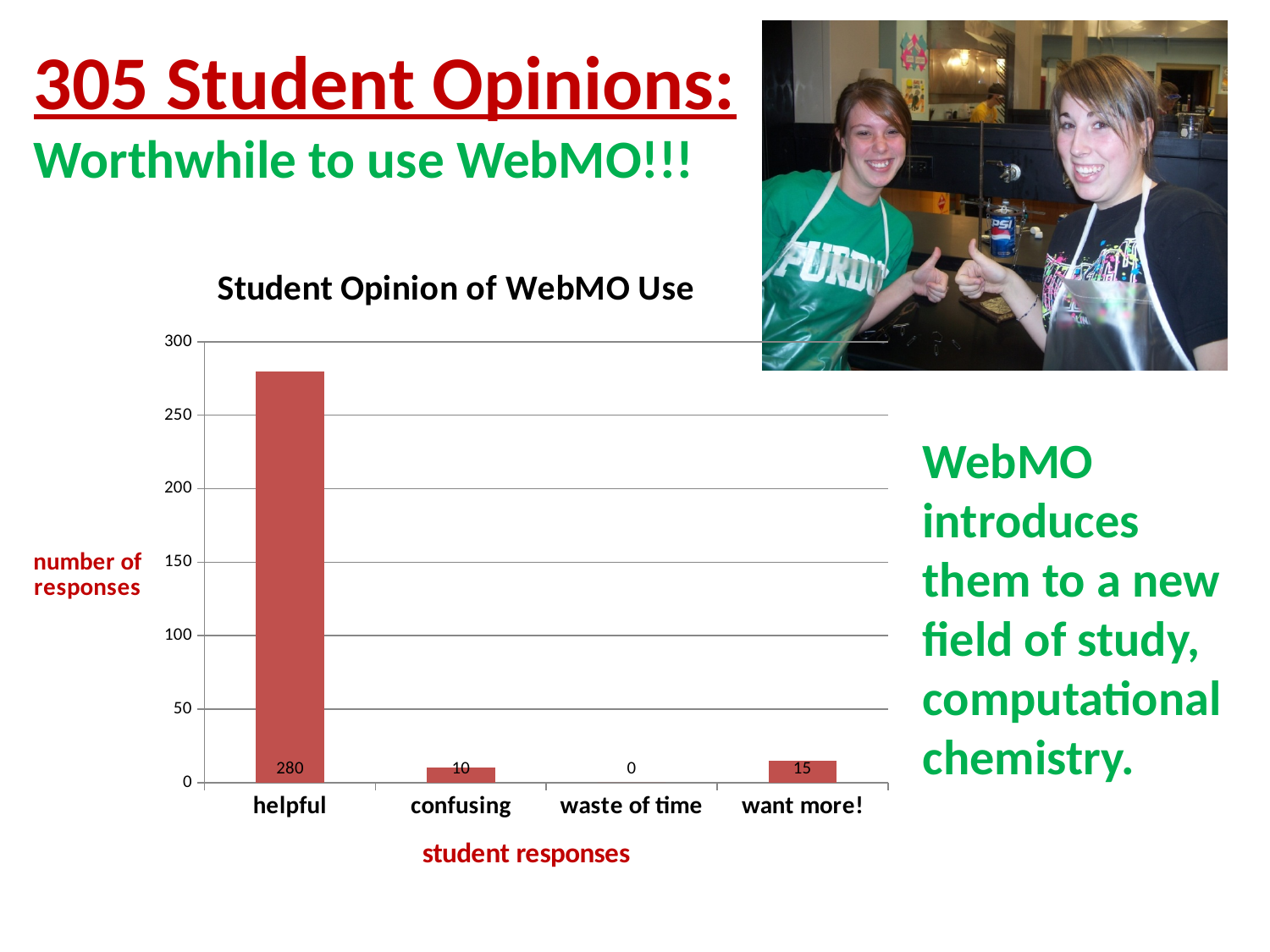
What is the number of responses for "confusing"? 10 What is the title of the chart? Student Opinion of WebMO Use What kind of chart is shown on the slide? bar chart Is the value for "helpful" greater or less than 250? greater Which student response category has the lowest number of responses? waste of time What is the number of responses for "waste of time"? 0 What is the number of responses for "want more!"? 15 What is the number of responses for "helpful"? 280 What is the difference in number of responses between "helpful" and "want more!"? 265 Which has more responses, "confusing" or "want more!"? want more! How many student response categories are shown on the x axis? 4 Which student response category has the highest number of responses? helpful